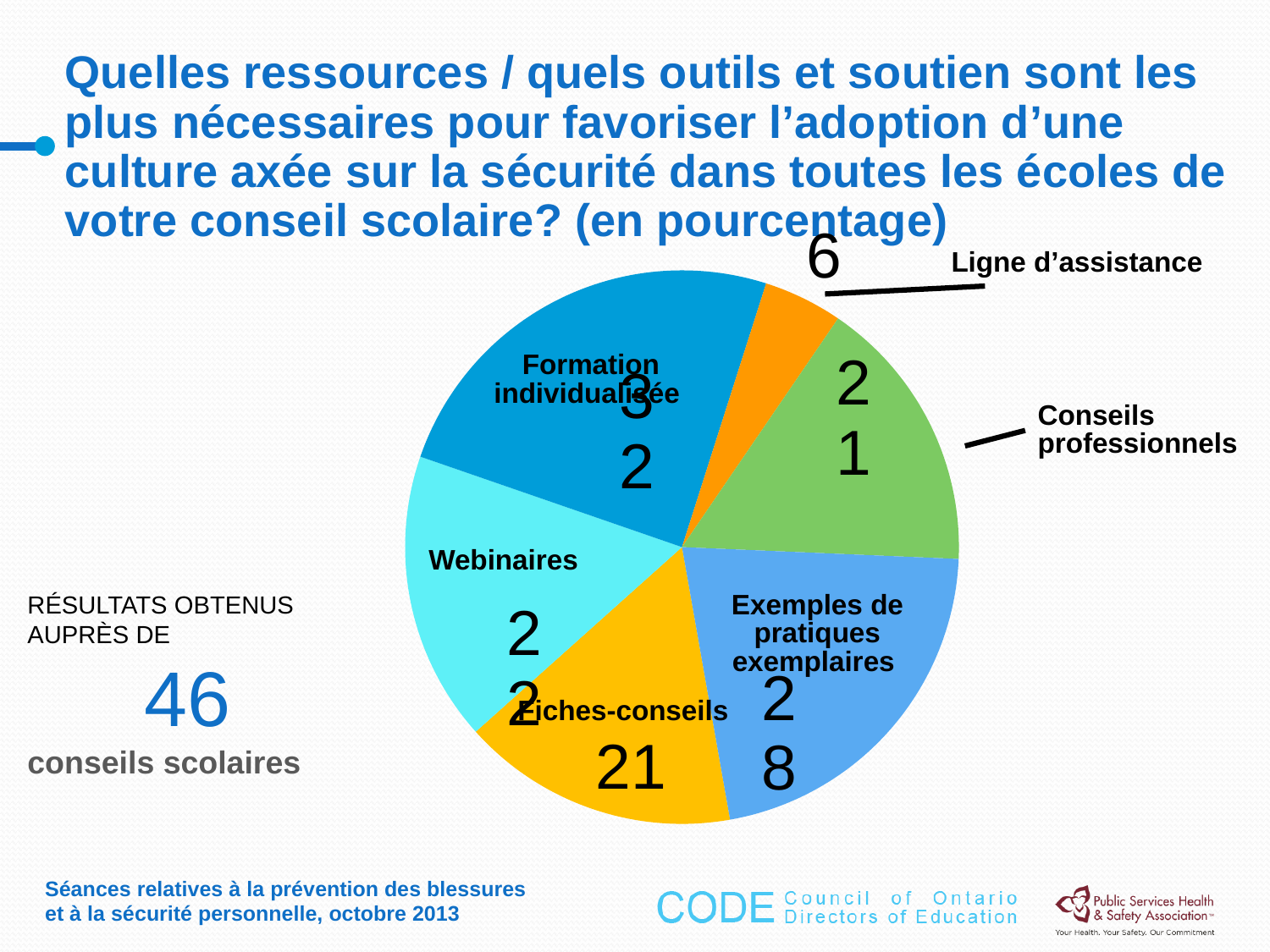
What is the value shown for Formation individualisée? 32 Which category has the smallest slice of the pie? Ligne d'assistance Which category has the largest slice of the pie? Formation individualisée What is the difference between the values for Exemples de pratiques exemplaires and Fiches-conseils? 7 How many slices does the pie chart have? 6 What is the value shown for Fiches-conseils? 21 What is the value shown for Ligne d'assistance? 6 What colour is the Fiches-conseils slice? Yellow Which is larger, the value for Exemples de pratiques exemplaires or the value for Ligne d'assistance? Exemples de pratiques exemplaires What kind of chart is shown on the slide? Pie chart What is the value shown for Exemples de pratiques exemplaires? 28 What is the value shown for Conseils professionnels? 21